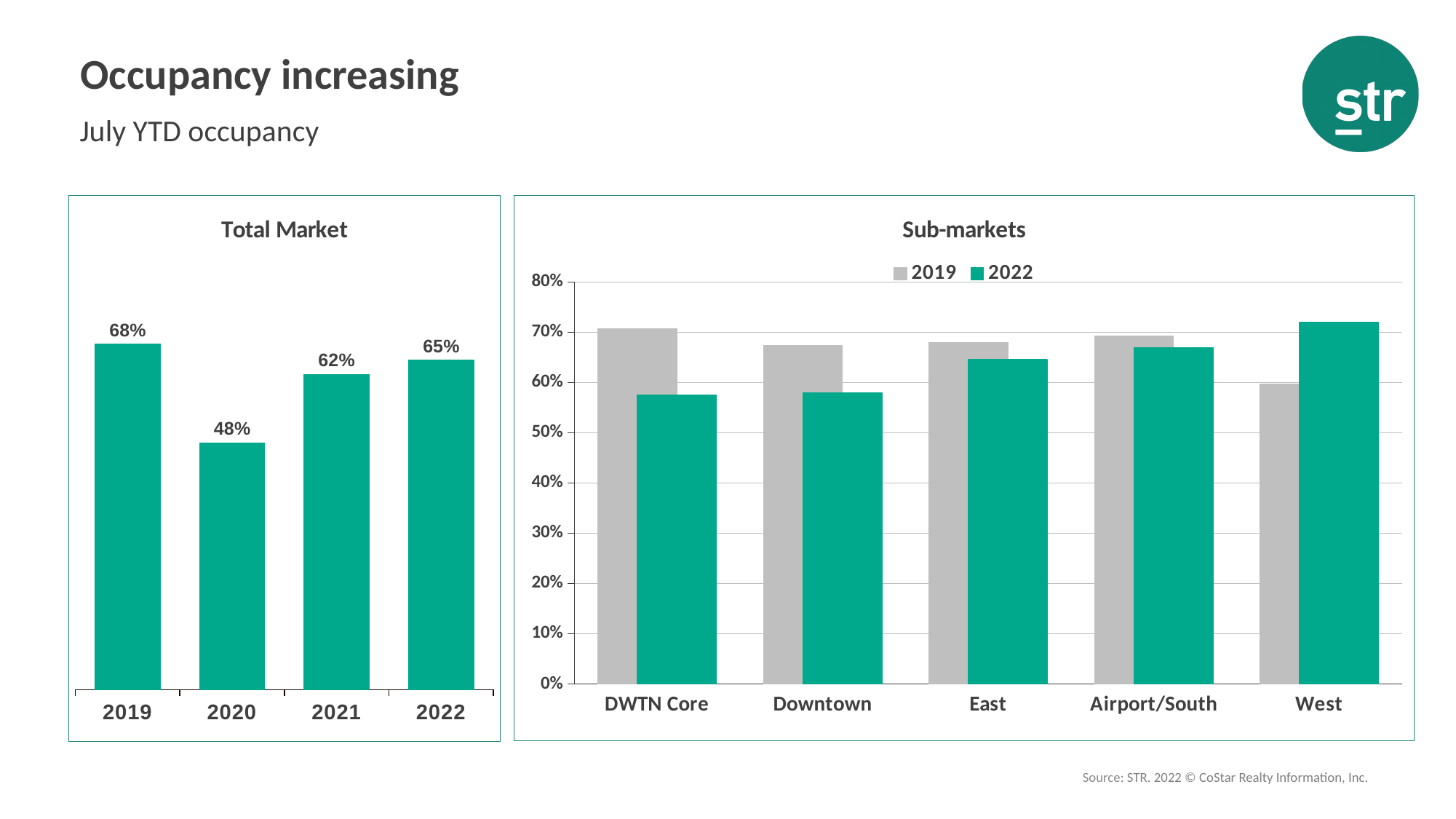
In the Sub-markets chart, is the 2022 value for DWTN Core greater or less than 60%? less In the Total Market chart, which year has the highest occupancy? 2019 In the Total Market chart, which year has the lowest occupancy? 2020 In the Sub-markets chart, for West, which is larger: the 2019 value or the 2022 value? 2022 What kind of chart is the Sub-markets chart? Bar chart In the Total Market chart, what is the difference between the 2019 and 2020 occupancy values? 20% In the Total Market chart, what is the occupancy value for 2020? 48% In the Total Market chart, what is the occupancy value for 2022? 65% In the Sub-markets chart, is the 2022 value for West greater or less than 70%? greater In the Sub-markets chart, how many series does the legend list? 2 In the Sub-markets chart, which sub-market has the highest 2022 value? West In the Total Market chart, how many years are shown on the x axis? 4